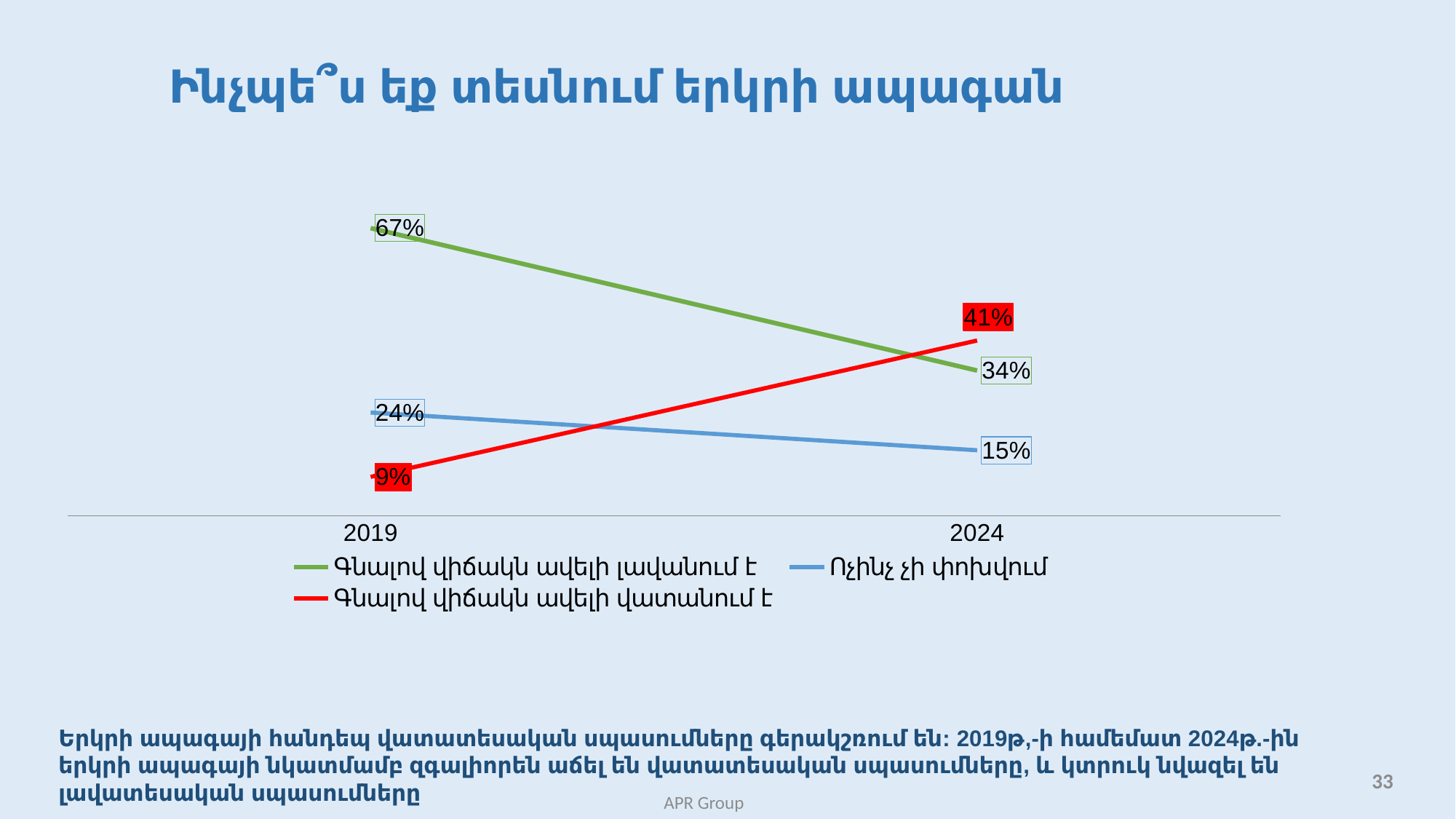
What type of chart is shown on the slide? line chart How many series does the legend list? 3 How many points are on the x axis? 2 Does the red series (Գնալով վիճակն ավելի վատանում է) rise or fall from 2019 to 2024? rise Which series has the highest value in 2024? Գնալով վիճակն ավելի վատանում է What is the value of the red series (Գնալով վիճակն ավելի վատանում է) in 2024? 41% What is the value of the green series (Գնալով վիճակն ավելի լավանում է) in 2019? 67% In 2019, which is larger: the blue series (Ոչինչ չի փոխվում) or the red series (Գնալով վիճակն ավելի վատանում է)? Ոչինչ չի փոխվում Which series has the lowest value in 2019? Գնալով վիճակն ավելի վատանում է What is the value of the blue series (Ոչինչ չի փոխվում) in 2019? 24% What is the value of the green series (Գնալով վիճակն ավելի լավանում է) in 2024? 34% By how many percentage points did the green series (Գնալով վիճակն ավելի լավանում է) change from 2019 to 2024? 33%